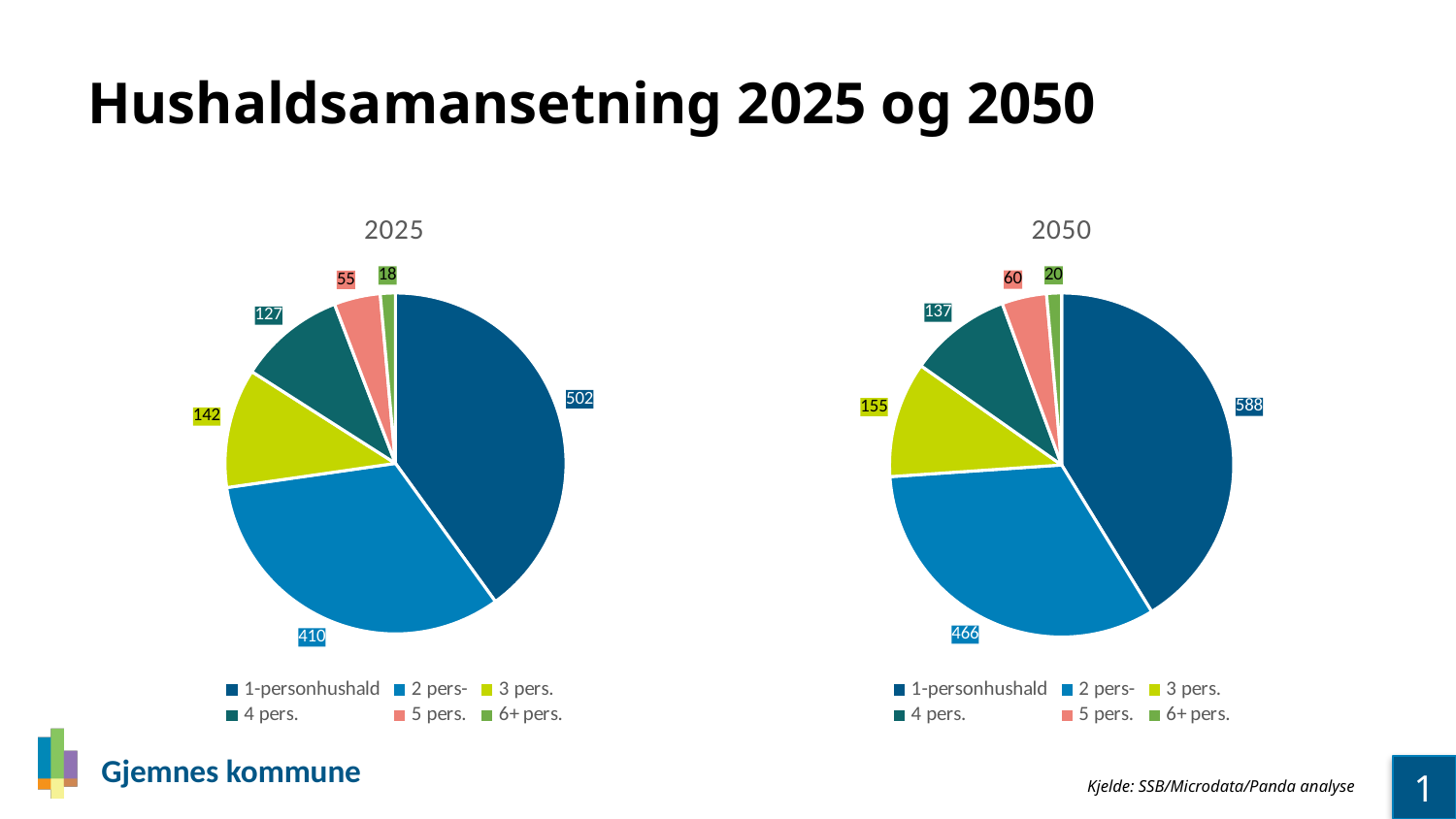
In the 2050 pie chart, which category has the largest value? 1-personhushald What is the difference between the 1-personhushald values in the 2050 and 2025 pie charts? 86 In the 2025 pie chart, what is the value for 4 pers.? 127 What is the title of the chart on the left? 2025 In the 2025 pie chart, what is the value for 1-personhushald? 502 What type of chart is used for the 2050 data? Pie chart In the 2050 pie chart, what is the value for 2 pers-? 466 How many categories does the 2025 pie chart show? 6 In the 2050 pie chart, which is larger: 3 pers. or 4 pers.? 3 pers. In the 2025 pie chart, what is the difference between the 3 pers. and 4 pers. values? 15 In the 2025 pie chart, which category has the smallest value? 6+ pers. In the 2050 pie chart, what is the value for 6+ pers.? 20